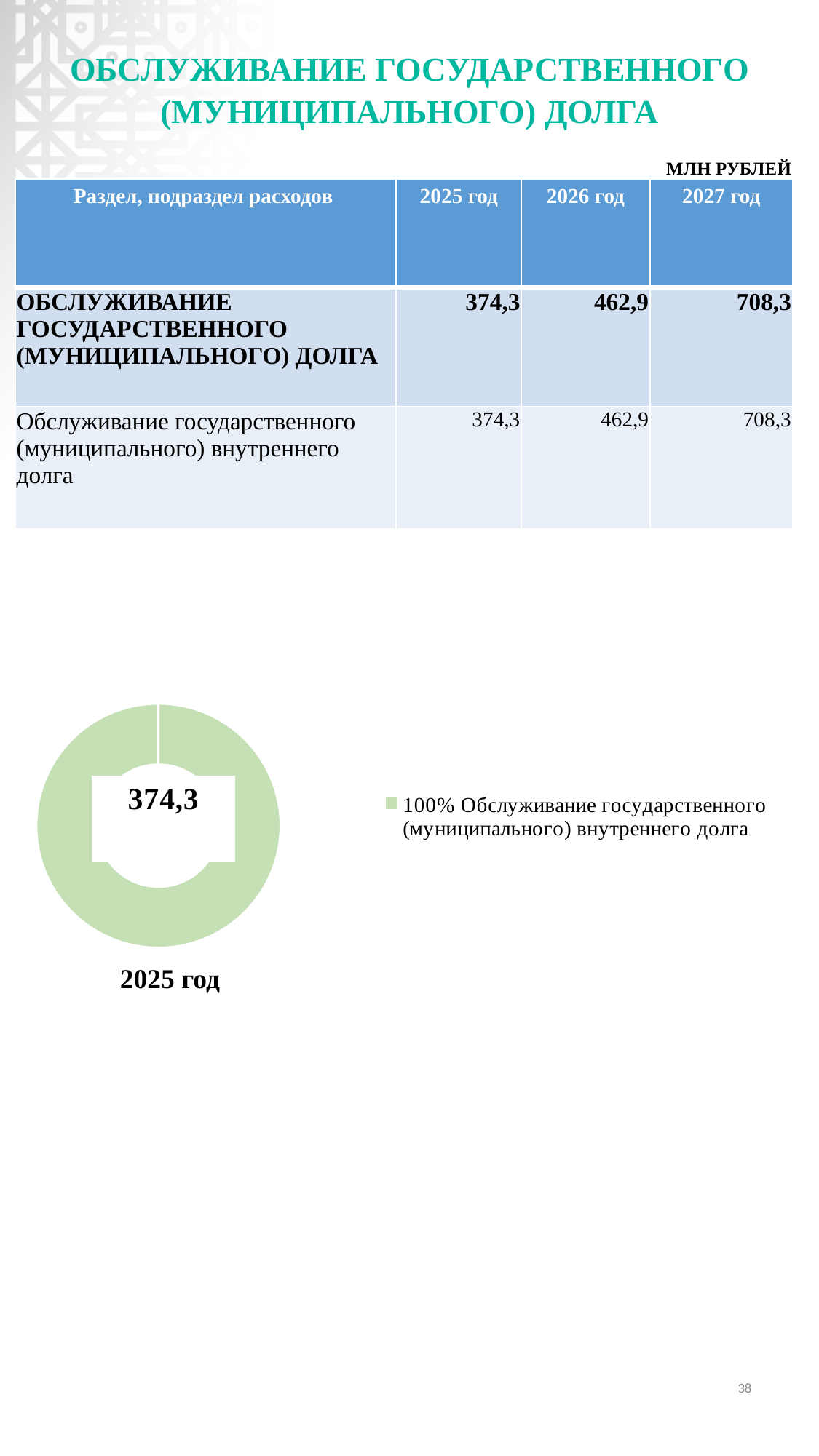
Which year does the doughnut chart represent, according to the label beneath it? 2025 год What is the legend entry of the doughnut chart? 100% Обслуживание государственного (муниципального) внутреннего долга Is the value shown in the centre of the doughnut chart greater or less than 300? greater What share of the doughnut chart does "Обслуживание государственного (муниципального) внутреннего долга" take? 100% What value is printed in the centre of the doughnut chart? 374,3 How many slices does the doughnut chart have? 1 What kind of chart is shown on the slide? doughnut (pie) chart How many entries does the legend of the doughnut chart list? 1